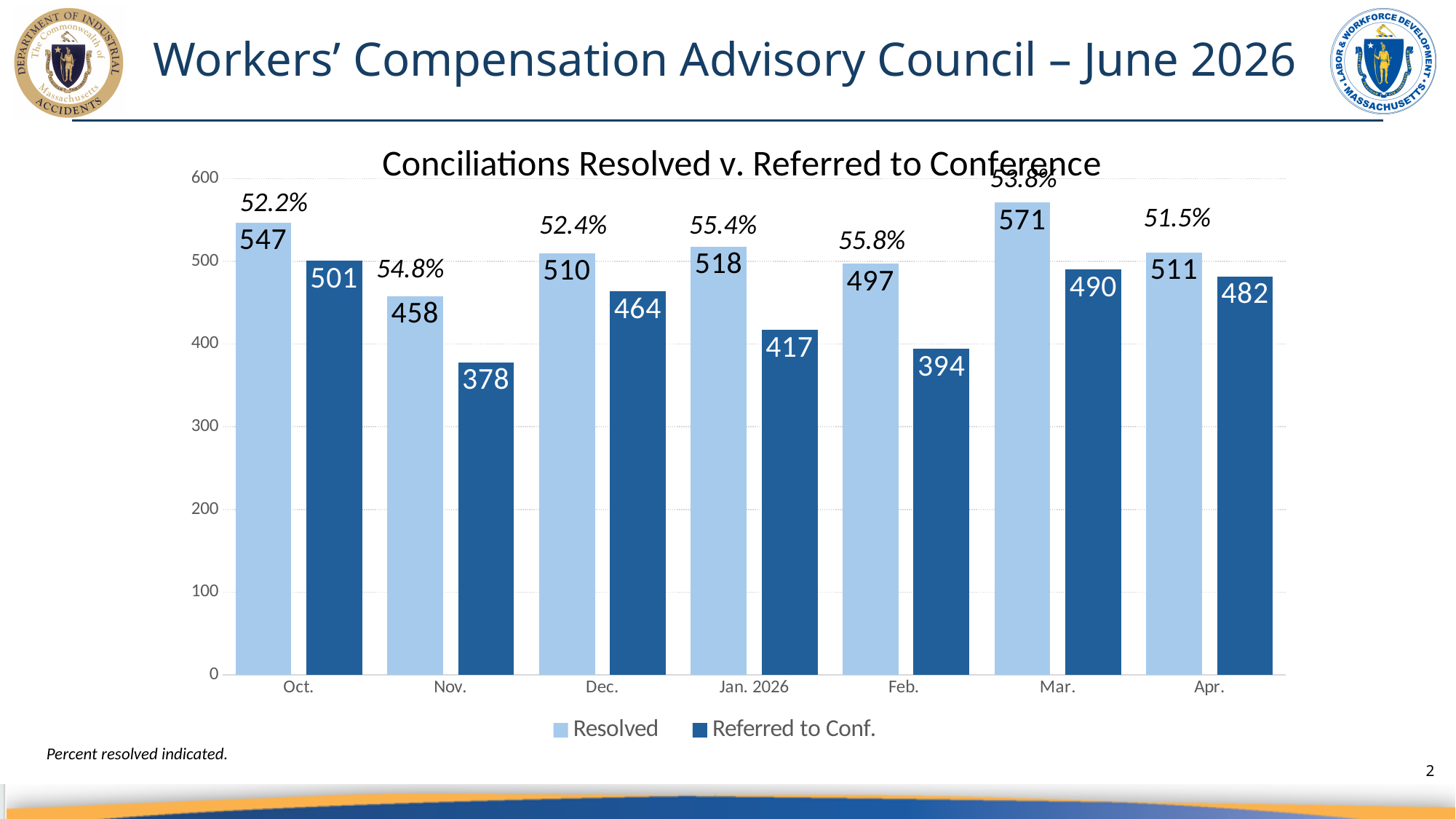
How many months are shown on the x axis? 7 What is the Referred to Conf. value for Nov.? 378 What is the difference between the Resolved and Referred to Conf. values for Jan. 2026? 101 How many series does the legend list? 2 What kind of chart is shown on the slide? Bar chart What is the Resolved value for Oct.? 547 What percent resolved is indicated for Feb.? 55.8% What is the total of Resolved and Referred to Conf. for Mar.? 1061 Which month has the highest Resolved value? Mar. Which is larger, the Referred to Conf. value for Dec. or for Apr.? Apr. Which month has the lowest Referred to Conf. value? Nov. What is the title of the chart? Conciliations Resolved v. Referred to Conference